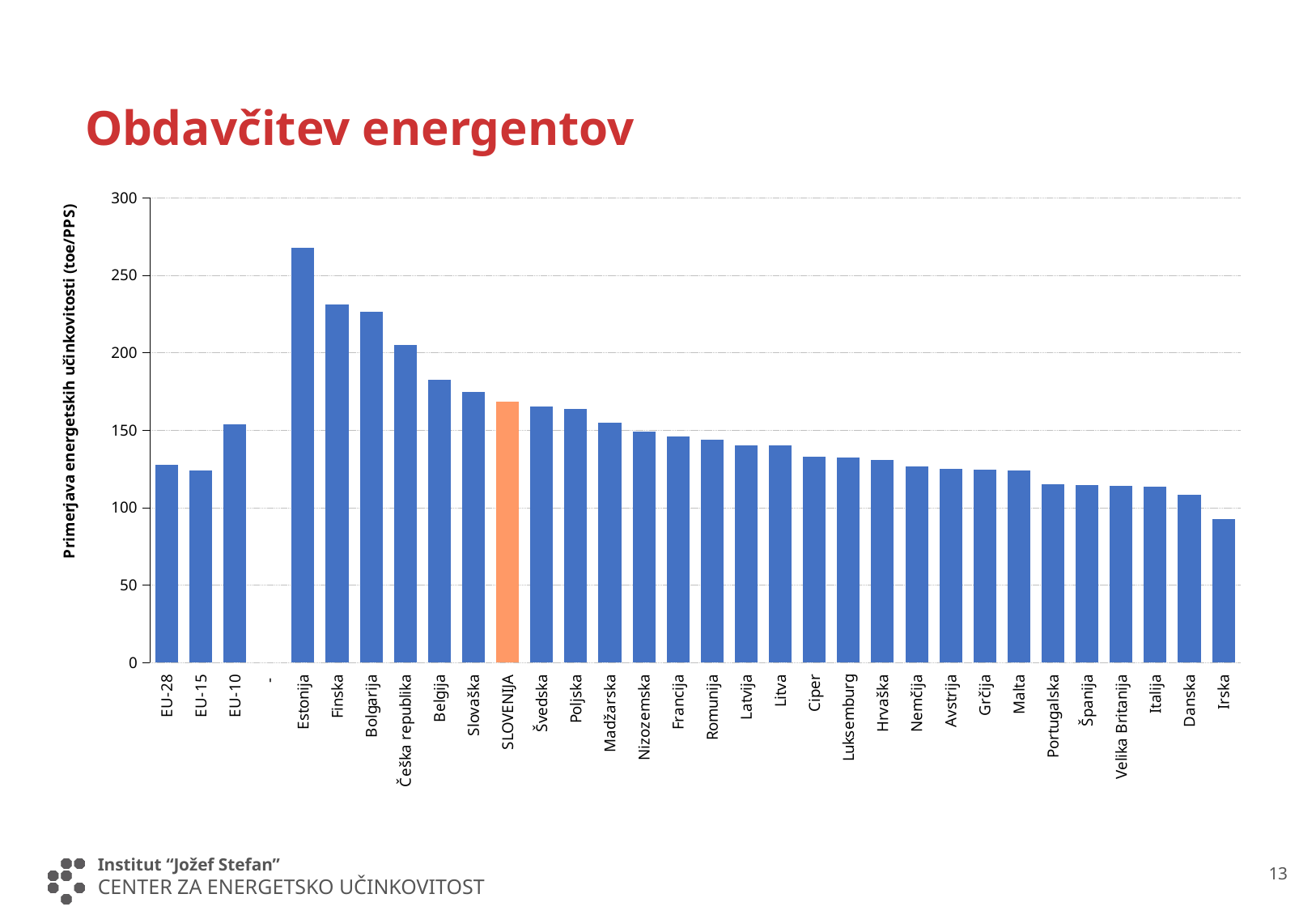
Which country has the lowest value in the chart? Irska Is the value for SLOVENIJA greater or less than 150? greater What kind of chart is shown on the slide? bar chart Do the values for the individual countries rise or fall from left to right along the x axis? fall Which country has the highest value in the chart? Estonija Is the value for Estonija greater or less than 250? greater Which bar is highlighted in orange? SLOVENIJA Is the value for Finska greater or less than 200? greater Which has a larger value, SLOVENIJA or EU-28? SLOVENIJA Which has a larger value, Estonija or Finska? Estonija